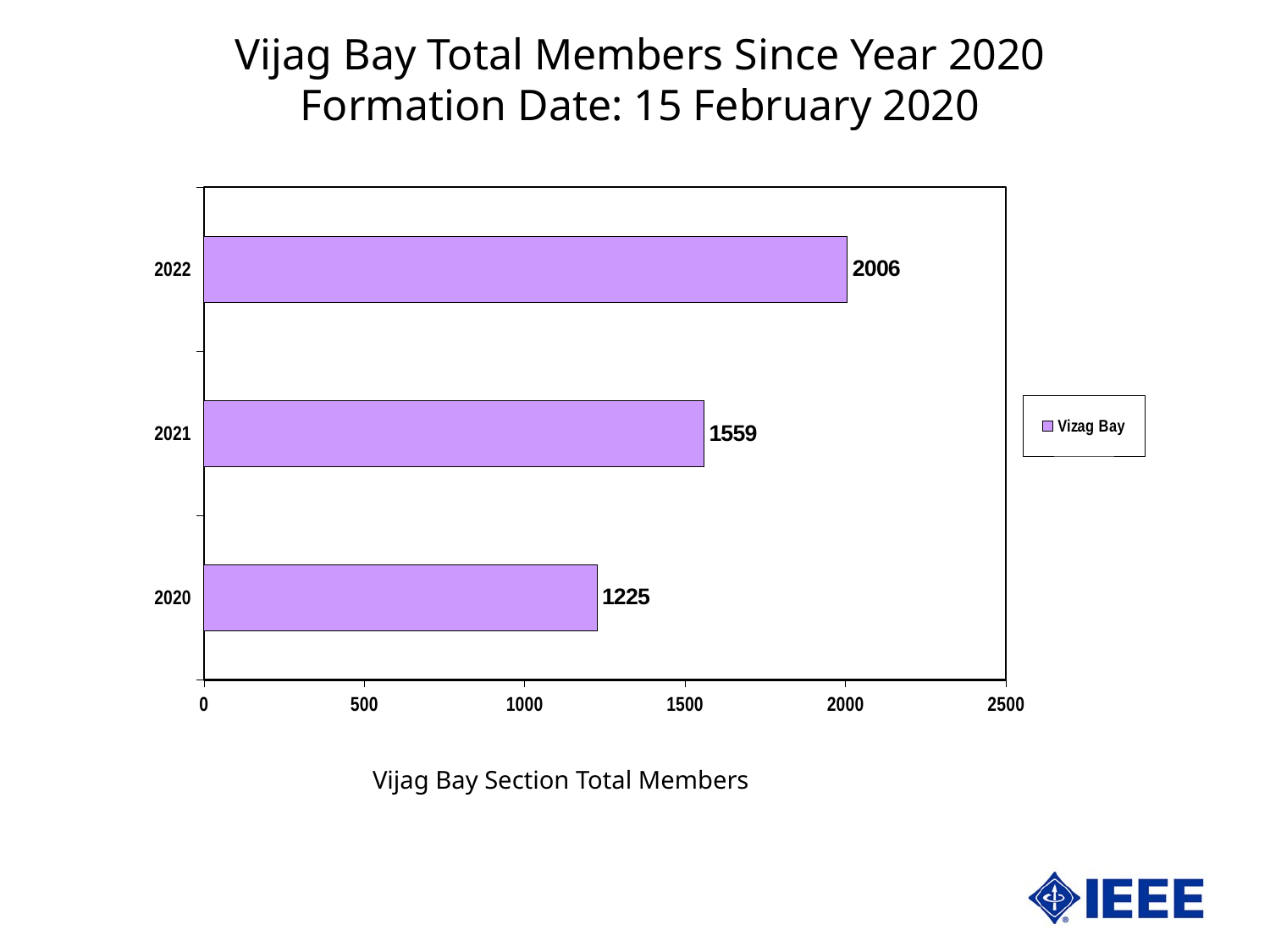
What kind of chart is shown on the slide? Bar chart What is the total number of members for 2022? 2006 Which year has the lowest number of members? 2020 Which year has the highest number of members? 2022 What is the difference in members between 2021 and 2020? 334 What is the difference in members between 2022 and 2020? 781 What series name does the legend show? Vizag Bay Is the value for 2021 greater or less than 1500? greater What is the total number of members for 2020? 1225 How many years are shown in the chart? 3 What is the total number of members for 2021? 1559 Which year has more members, 2021 or 2022? 2022